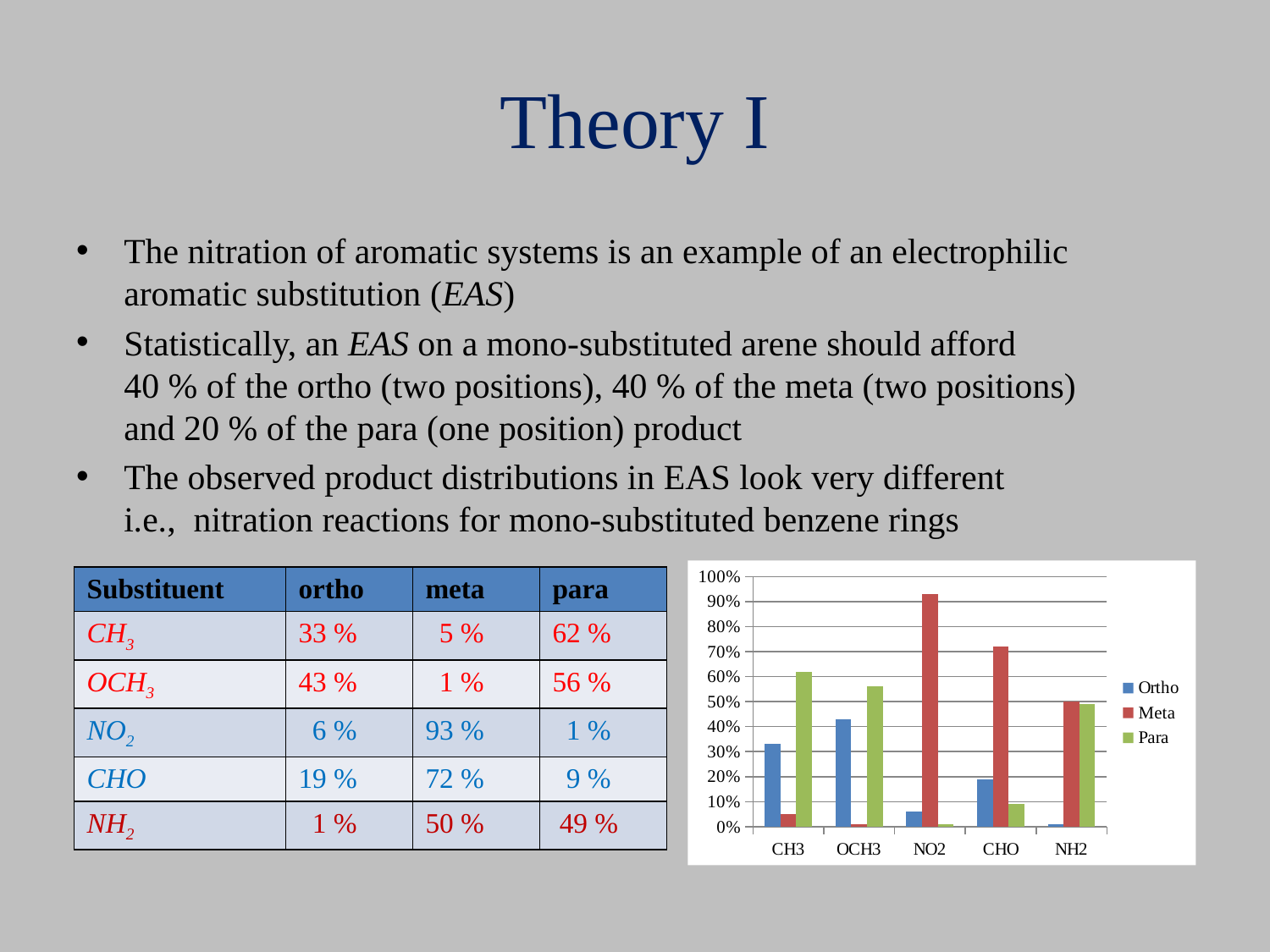
Is the Ortho value for OCH3 greater or less than 40%? greater Which substituent has the highest Para value in the chart? CH3 Which substituent has the highest Meta value in the chart? NO2 Which is larger for CH3: the Ortho value or the Para value? Para How many series does the chart legend list? 3 How many substituent categories are shown on the x axis of the chart? 5 Is the Meta value for NO2 greater or less than 90%? greater Is the Para value for CHO greater or less than 10%? less What colour are the Meta bars in the chart? red What kind of chart is shown on the slide? bar chart Which is larger for CHO: the Meta value or the Ortho value? Meta Which substituent has the lowest Ortho value in the chart? NH2